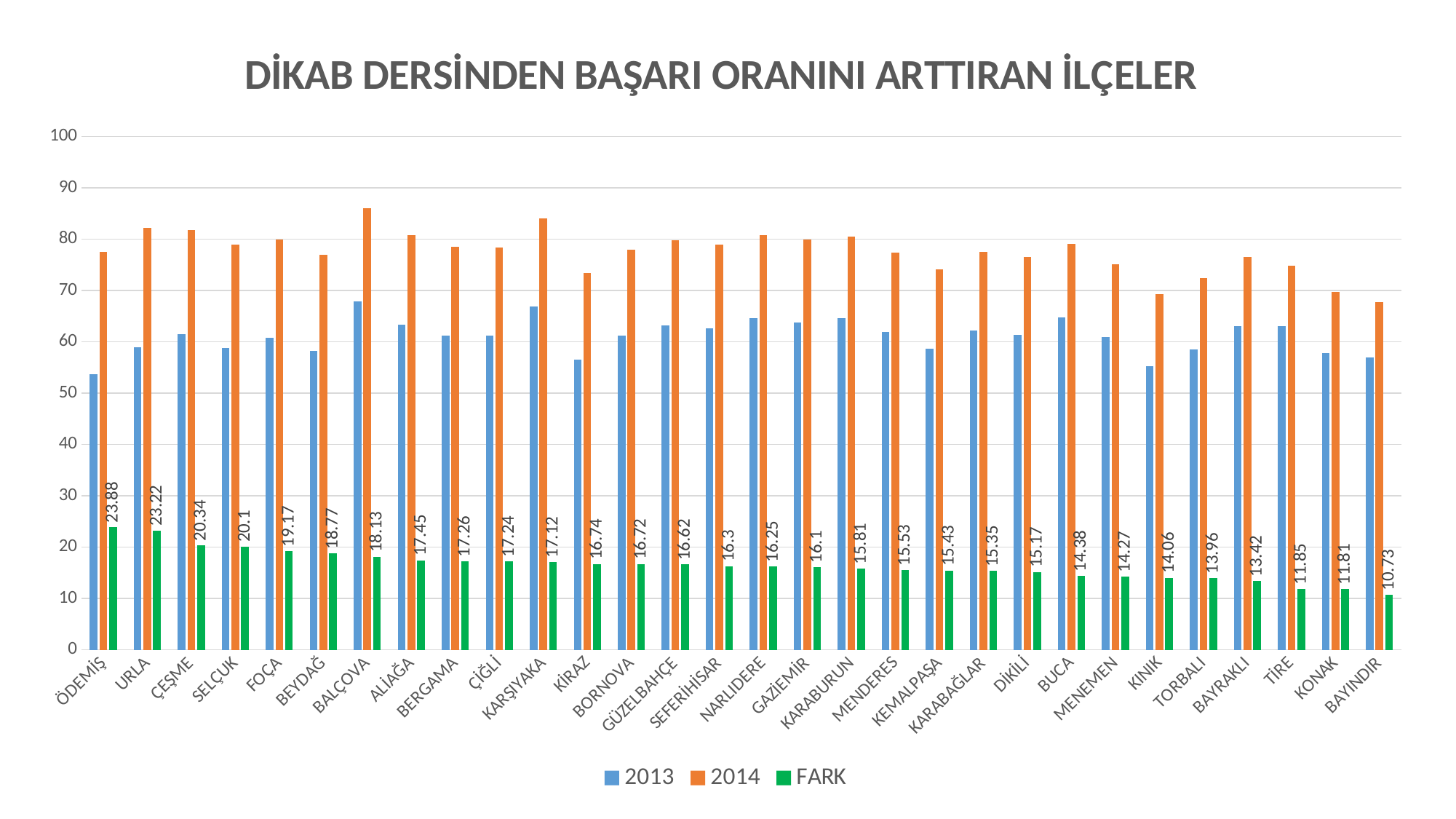
How many series does the legend list? 3 Which district has the highest FARK value? ÖDEMİŞ What is the FARK value for KONAK? 11.81 What is the difference between the FARK values of ÖDEMİŞ and BAYINDIR? 13.15 Which has a larger FARK value, URLA or ÇEŞME? URLA What kind of chart is shown on the slide? bar chart How many districts are shown on the x axis? 30 Is the 2014 value for BALÇOVA greater or less than 80? greater What is the FARK value for ÖDEMİŞ? 23.88 Do the FARK values rise or fall from left to right along the x axis? fall Which district has the lowest FARK value? BAYINDIR Is the 2013 value for KINIK greater or less than 60? less